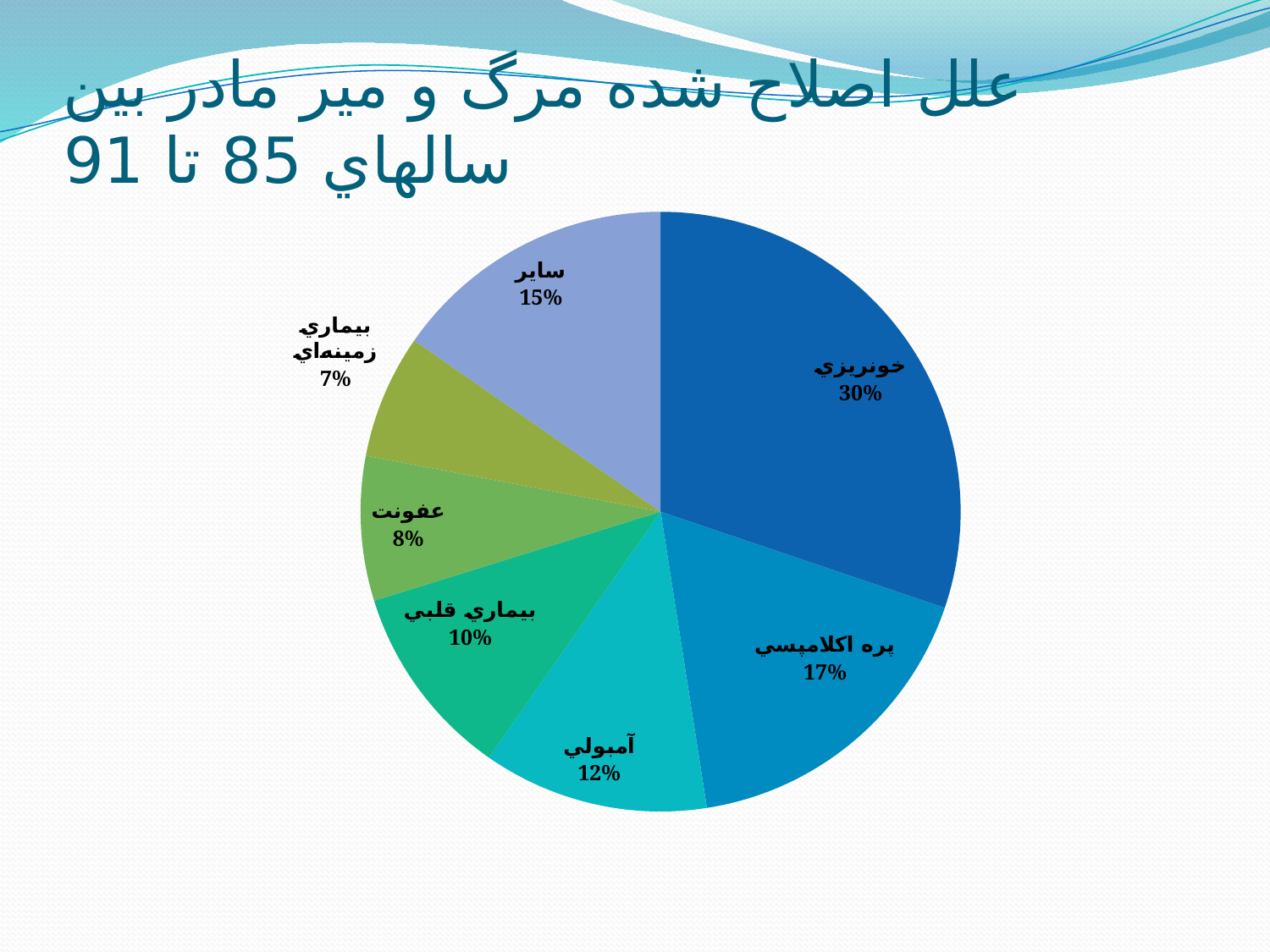
What is the value labelled for آمبولي? 12% What is the difference in percentage points between خونريزي and پره اكلامپسي? 13 Which is larger, the slice for عفونت or the slice for بيماري قلبي? بيماري قلبي What kind of chart is shown on the slide? Pie chart How many categories are shown in the pie chart? 7 What share of the pie does خونريزي represent? 30% What percentage is shown for بيماري زمينه‌اي? 7% What is the combined share of عفونت and بيماري زمينه‌اي? 15% Which is larger, the slice for ساير or the slice for آمبولي? ساير What percentage is shown for پره اكلامپسي? 17% Which category has the smallest slice of the pie? بيماري زمينه‌اي Which category has the largest slice of the pie? خونريزي